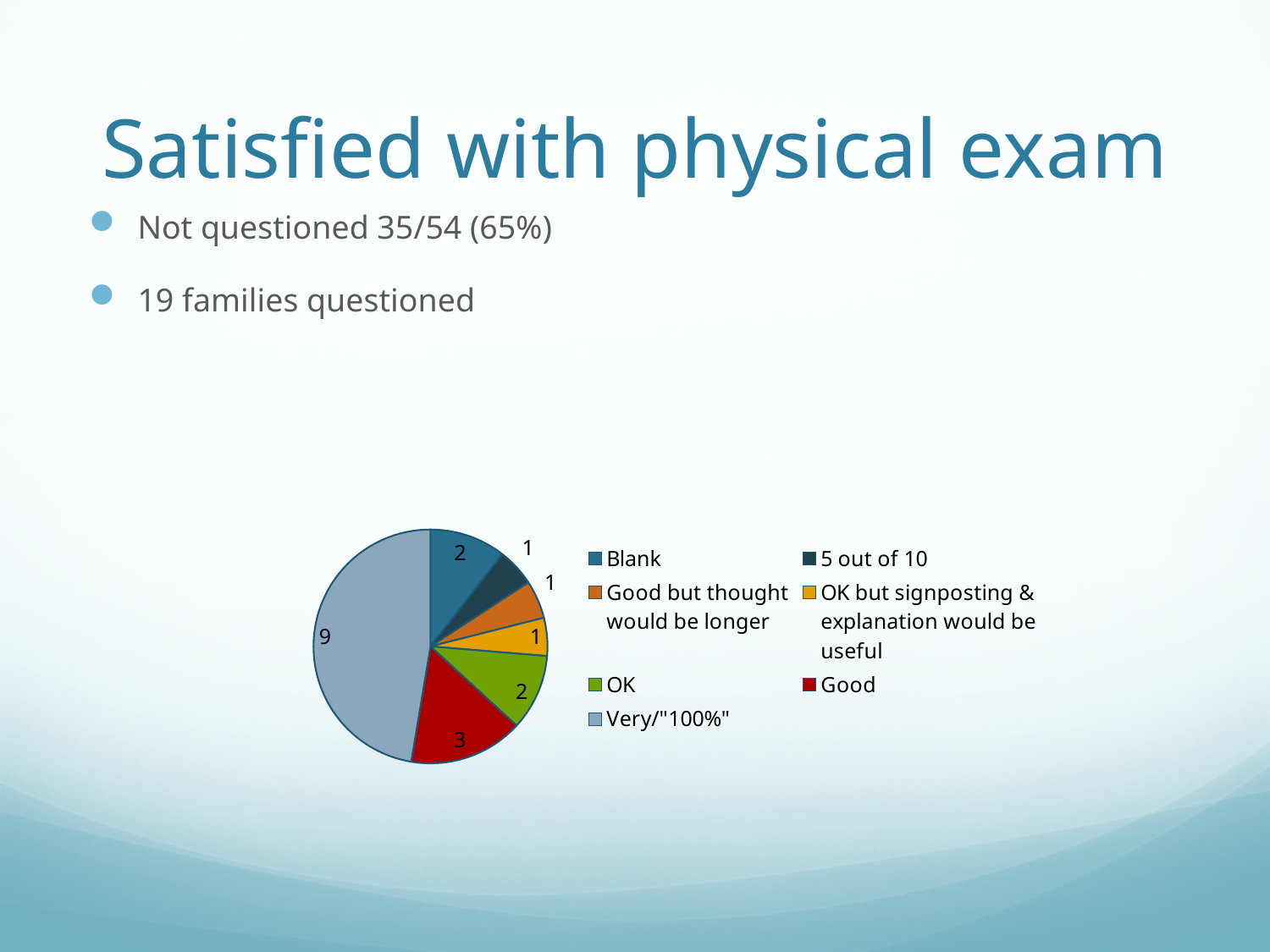
What is the difference between the Very/"100%" slice and the Good slice in the pie chart? 6 How many slices does the pie chart have? 7 Which slice is larger in the pie chart, Good or Blank? Good What is the value of the Good slice in the pie chart? 3 What kind of chart is shown on the slide? pie chart How many entries does the legend of the pie chart list? 7 What is the total of all the slice values in the pie chart? 19 What is the value of the Very/"100%" slice in the pie chart? 9 Which category has the largest slice in the pie chart? Very/"100%" What colour is the Good slice in the pie chart? red What is the value of the Blank slice in the pie chart? 2 What is the value of the 5 out of 10 slice in the pie chart? 1